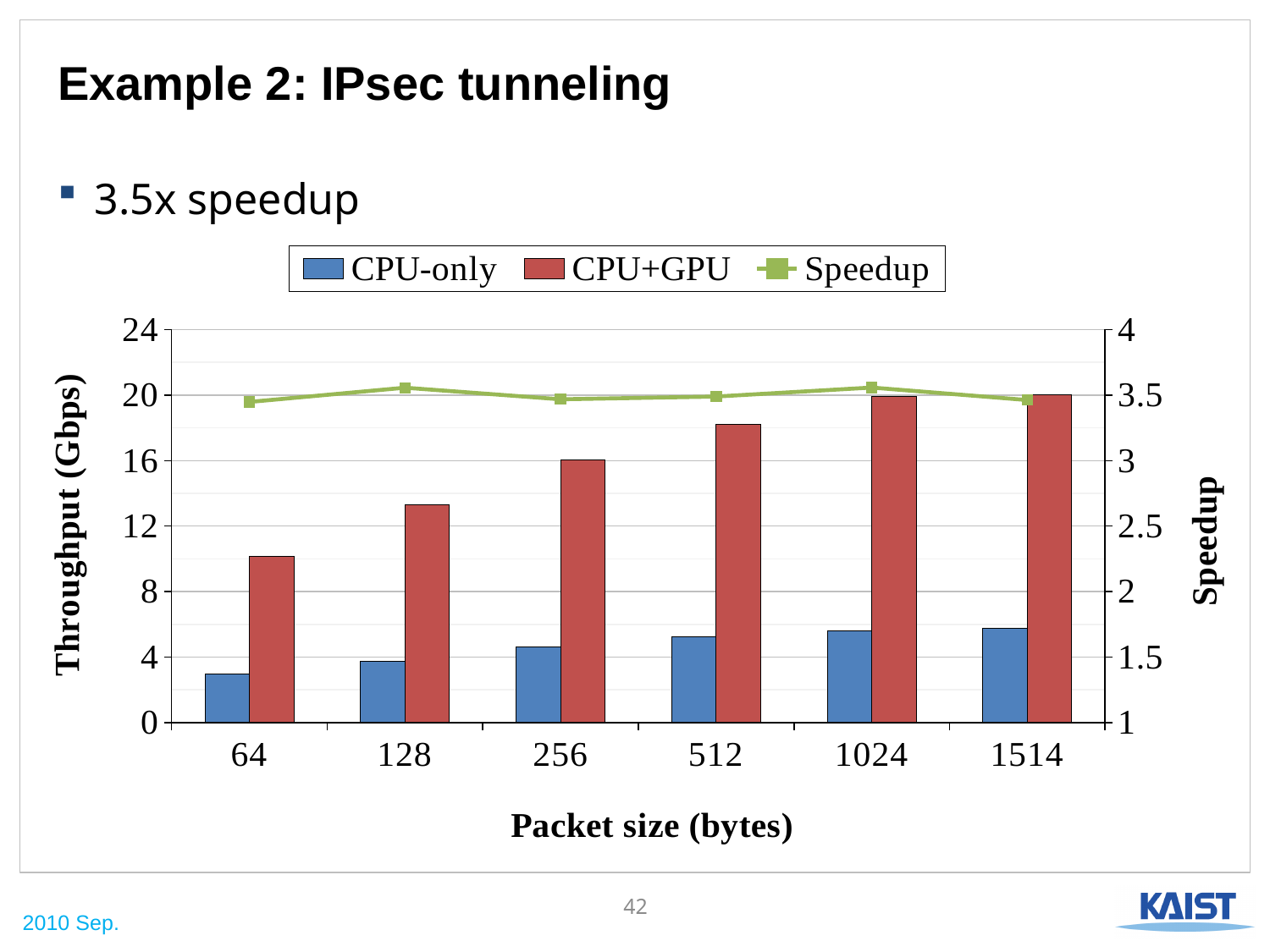
Which packet size has the lowest CPU-only throughput? 64 Does the CPU+GPU throughput rise or fall as packet size increases along the x axis? rise Is the CPU-only throughput for packet size 1514 greater or less than 4 Gbps? greater What is the label of the left vertical axis of the chart? Throughput (Gbps) What kind of chart is shown on the slide? A combined bar and line chart Which is larger: the CPU+GPU throughput at packet size 128 or at packet size 256? 256 Is the CPU-only throughput for packet size 64 greater or less than 4 Gbps? less Which packet size has the lowest CPU+GPU throughput? 64 How many series does the chart's legend list? 3 Is the CPU+GPU throughput for packet size 64 greater or less than 8 Gbps? greater How many packet sizes are shown on the x axis of the chart? 6